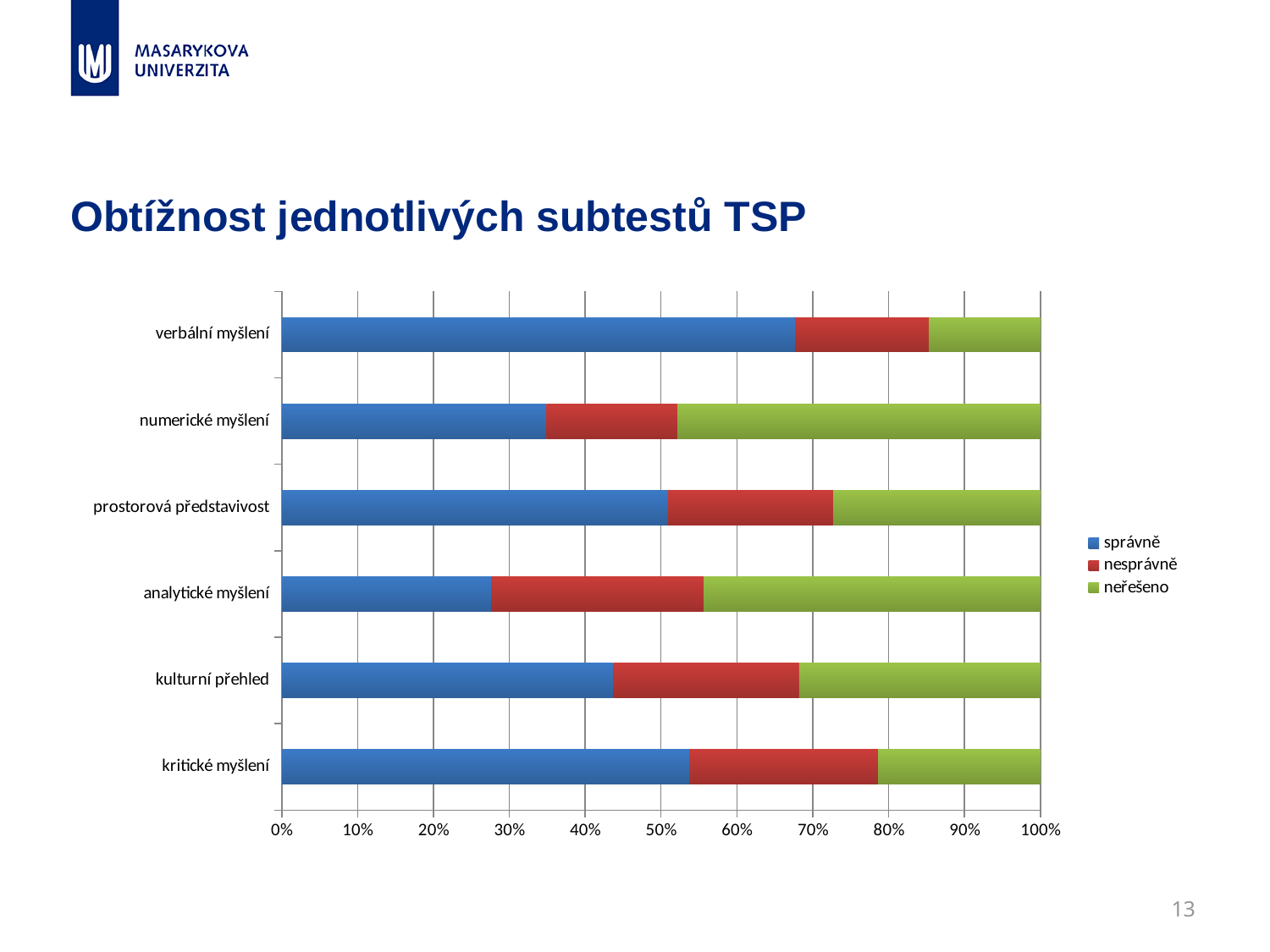
Which subtest has the smallest share of 'správně'? analytické myšlení What kind of chart is shown on the slide? stacked bar chart What is the total of the stacked bar for kulturní přehled? 100% Is the 'správně' share for numerické myšlení greater or less than 40%? less Which subtest has the largest share of 'správně'? verbální myšlení Is the 'správně' share for kritické myšlení greater or less than 50%? greater How many subtests (categories) are shown in the chart? 6 How many series does the legend list? 3 Which has a larger 'správně' share: verbální myšlení or numerické myšlení? verbální myšlení Is the 'správně' share for verbální myšlení greater or less than 60%? greater Which has a larger 'neřešeno' share: numerické myšlení or verbální myšlení? numerické myšlení What is the title of the chart slide? Obtížnost jednotlivých subtestů TSP